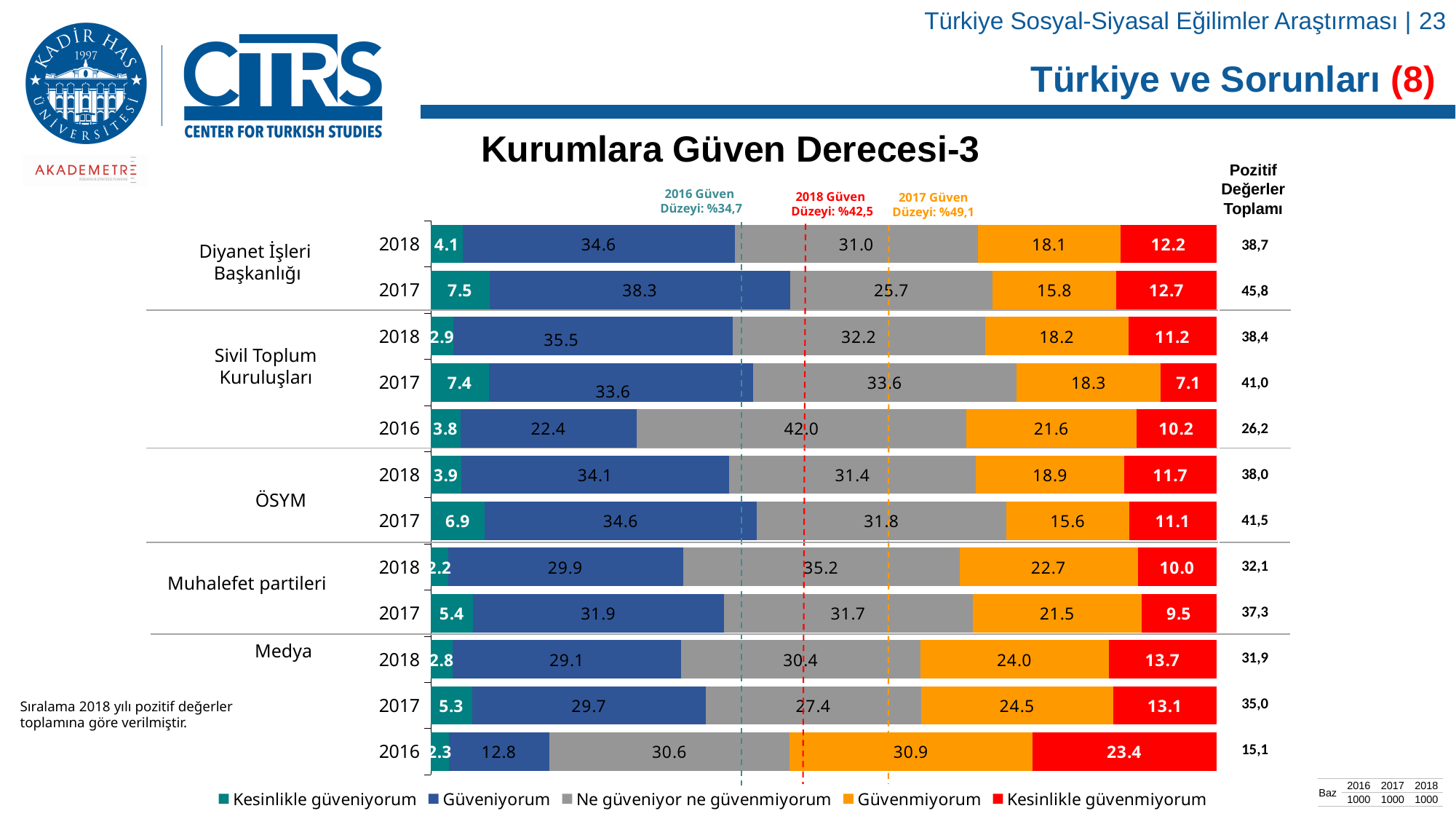
Which has the larger "Güvenmiyorum" value in 2018: Medya or Muhalefet partileri? Medya How many bars are plotted in the chart? 12 What is the 2018 Güven Düzeyi shown by the red dashed line? %42,5 What is the Pozitif Değerler Toplamı for ÖSYM in 2017? 41,5 Which bar has the highest "Ne güveniyor ne güvenmiyorum" value? Sivil Toplum Kuruluşları 2016 What kind of chart is shown on the slide? Stacked bar chart How much higher is the "Kesinlikle güveniyorum" value for Diyanet İşleri Başkanlığı in 2017 than in 2018? 3.4 How many series does the legend list? 5 What is the "Kesinlikle güvenmiyorum" value for Medya in 2016? 23.4 Did the "Kesinlikle güveniyorum" value for Diyanet İşleri Başkanlığı rise or fall from 2017 to 2018? Fall Which bar has the highest "Kesinlikle güvenmiyorum" value? Medya 2016 What is the "Güveniyorum" value for Diyanet İşleri Başkanlığı in 2018? 34.6